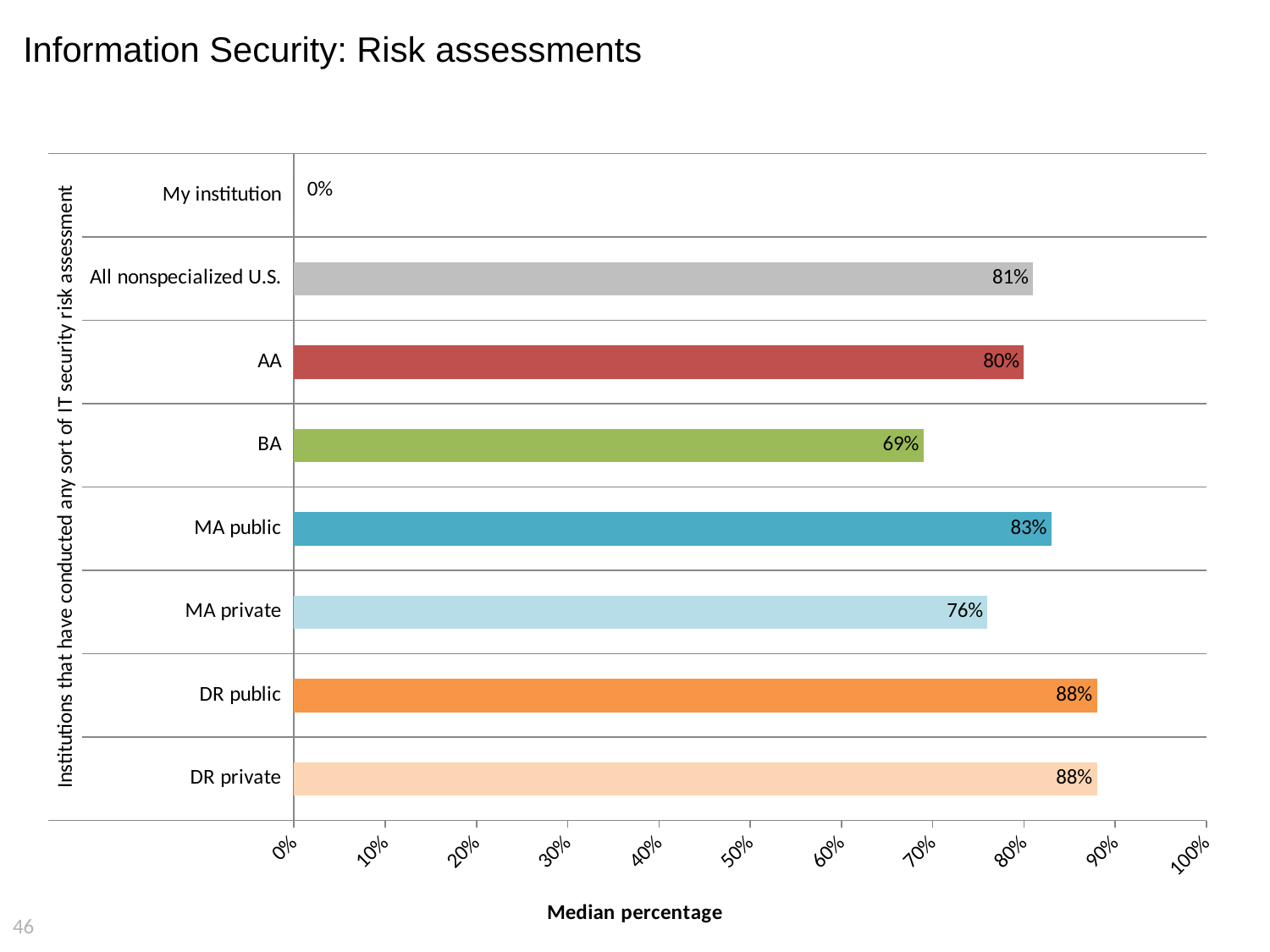
What is the value for MA public? 83% Which category has the lowest value? My institution What is the value for My institution? 0% What is the value for All nonspecialized U.S.? 81% What is the difference between the values for DR public and MA private? 12% What is the x-axis title of the chart? Median percentage Is the value for MA private greater or less than 70%? greater What kind of chart is shown on the slide? Bar chart How many categories are shown on the chart? 8 Which is larger, the value for AA or the value for BA? AA What is the value for BA? 69% Excluding My institution, which category has the lowest value? BA